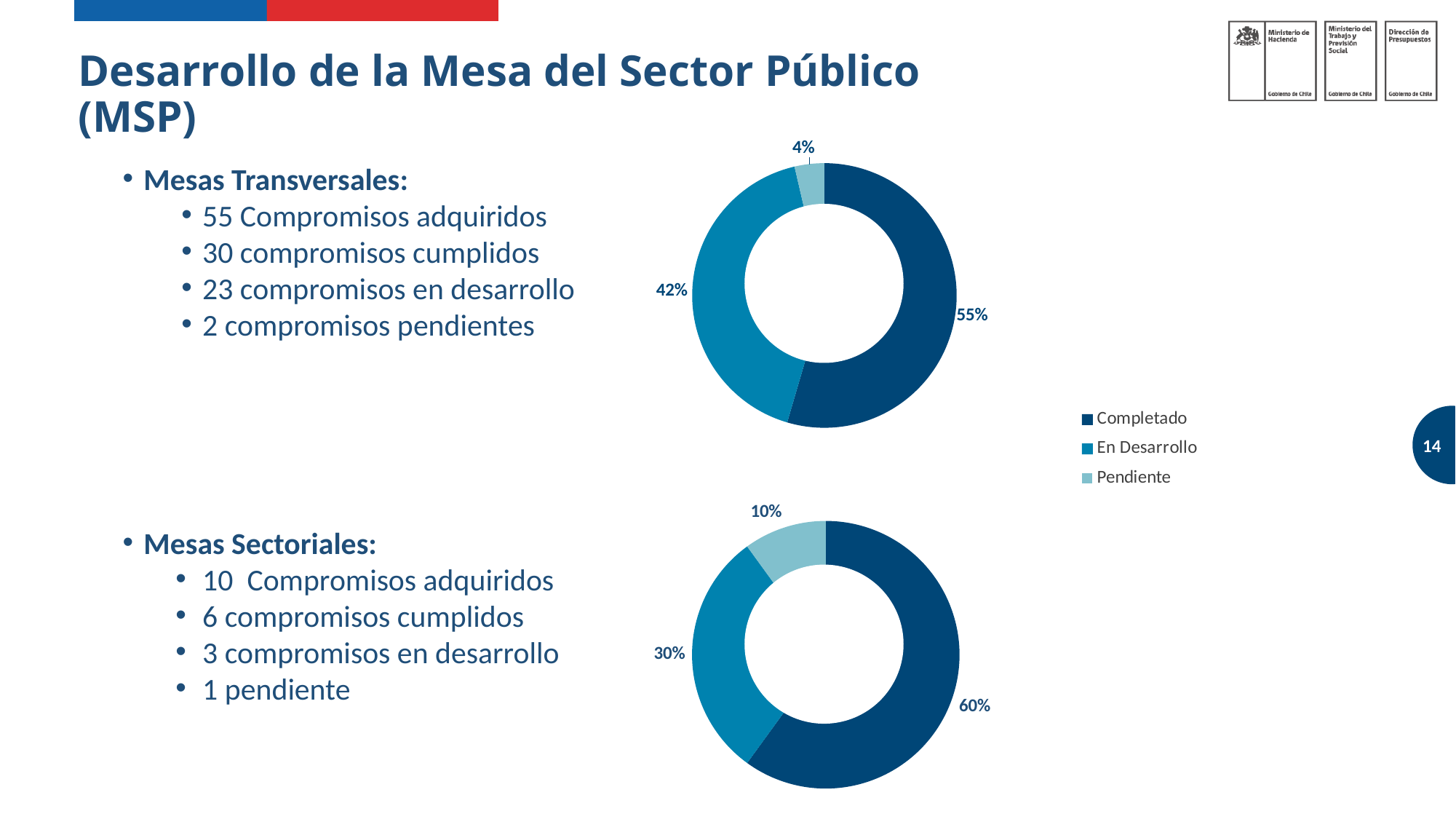
In the top donut chart, what percentage is shown for En Desarrollo? 42% In the bottom donut chart, which category has the smallest share? Pendiente In the top donut chart, what percentage is shown for Completado? 55% Which is larger in the bottom donut chart: En Desarrollo or Pendiente? En Desarrollo In the bottom donut chart, what percentage is shown for En Desarrollo? 30% In the bottom donut chart, what percentage is shown for Pendiente? 10% In the bottom donut chart, what percentage is shown for Completado? 60% How many series does the legend list? 3 In the top donut chart, what is the difference in percentage points between Completado and En Desarrollo? 13 What type of chart is the top chart on the slide? Donut chart In the top donut chart, which category has the largest share? Completado In the top donut chart, what percentage is shown for Pendiente? 4%